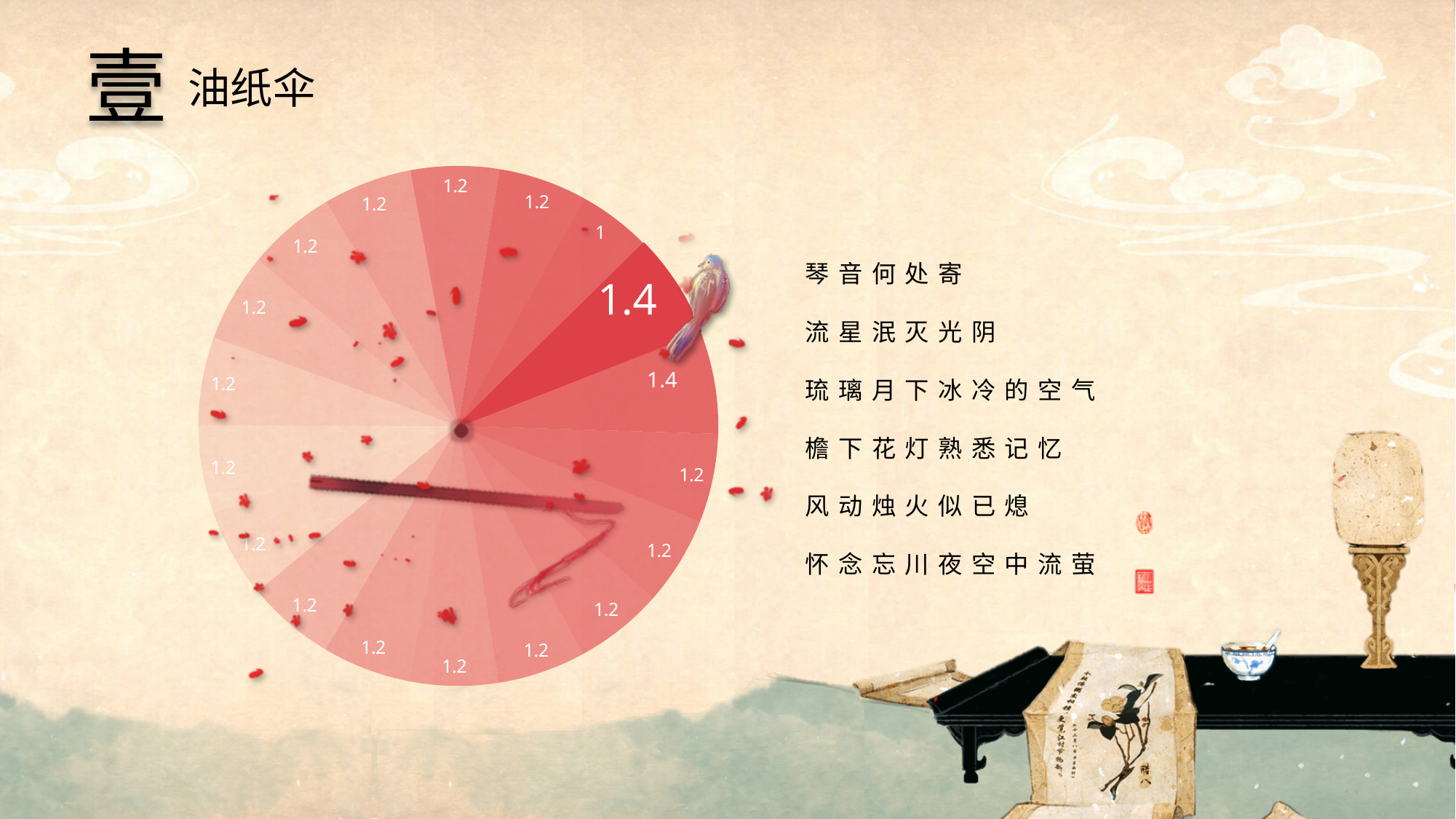
What value is printed on the darkest red slice of the pie chart? 1.4 Is the value on the darkest red slice greater or less than 1? greater How many slices of the pie chart are labeled 1? 1 What kind of chart is shown on the slide? pie chart How many slices of the pie chart are labeled 1.4? 2 What value is printed on most of the slices of the pie chart? 1.2 What is the largest value labeled on any slice of the pie chart? 1.4 What is the title text at the top of the slide next to the large character 壹? 油纸伞 What is the smallest value labeled on any slice of the pie chart? 1 Which is larger: the value on the darkest red slice or the value on the slice labeled 1? the darkest red slice (1.4) Does the pie chart have a legend? No What is the difference between the largest and smallest values labeled on the pie chart? 0.4